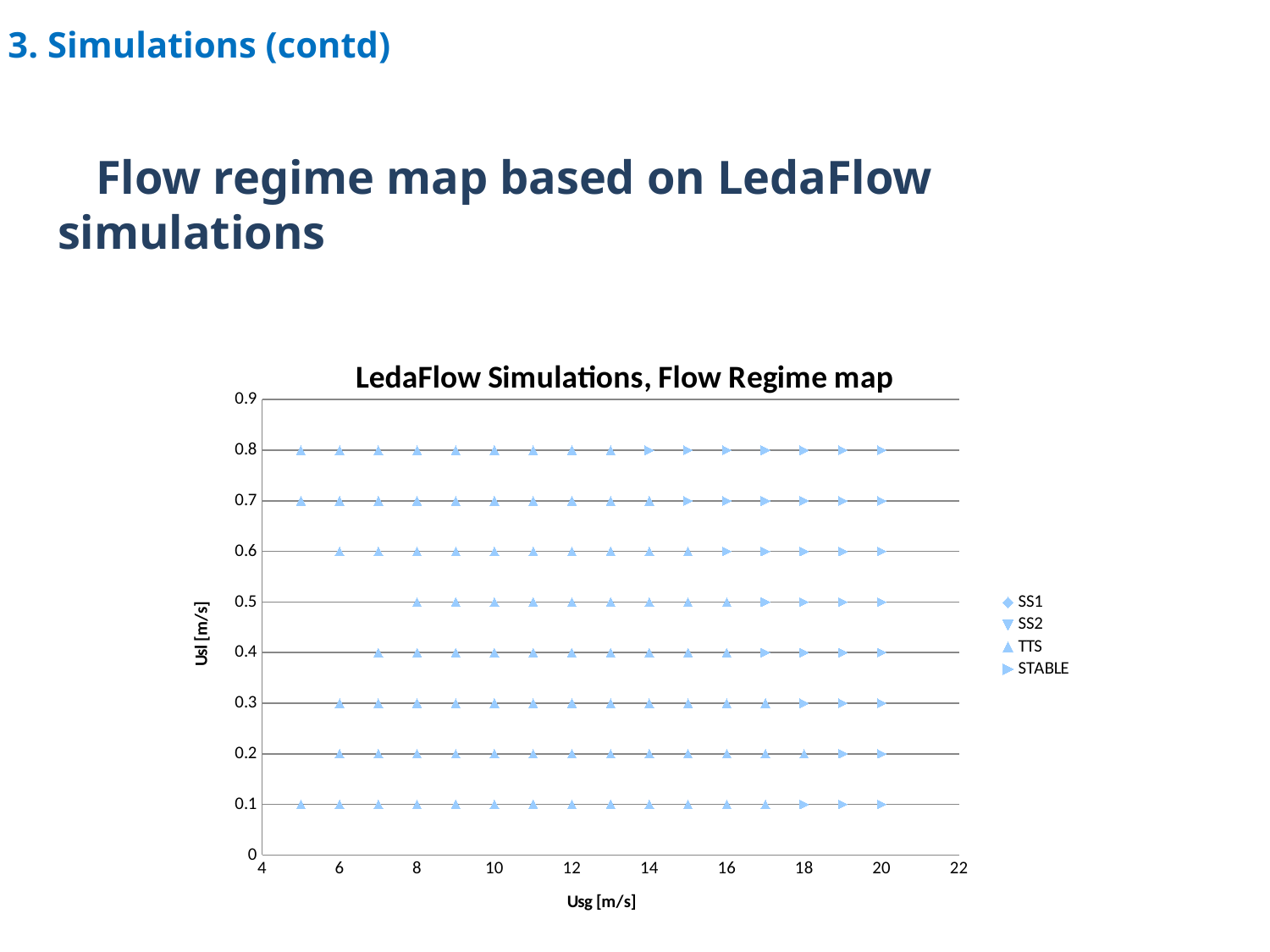
Which series do the points at Usg = 5 m/s belong to? TTS What is the label of the x axis? Usg [m/s] What kind of chart is shown on the slide? scatter chart How many series does the legend list? 4 What is the title of the chart? LedaFlow Simulations, Flow Regime map Which series do the points at Usg = 20 m/s belong to? STABLE Which series has the most plotted points on the chart? TTS